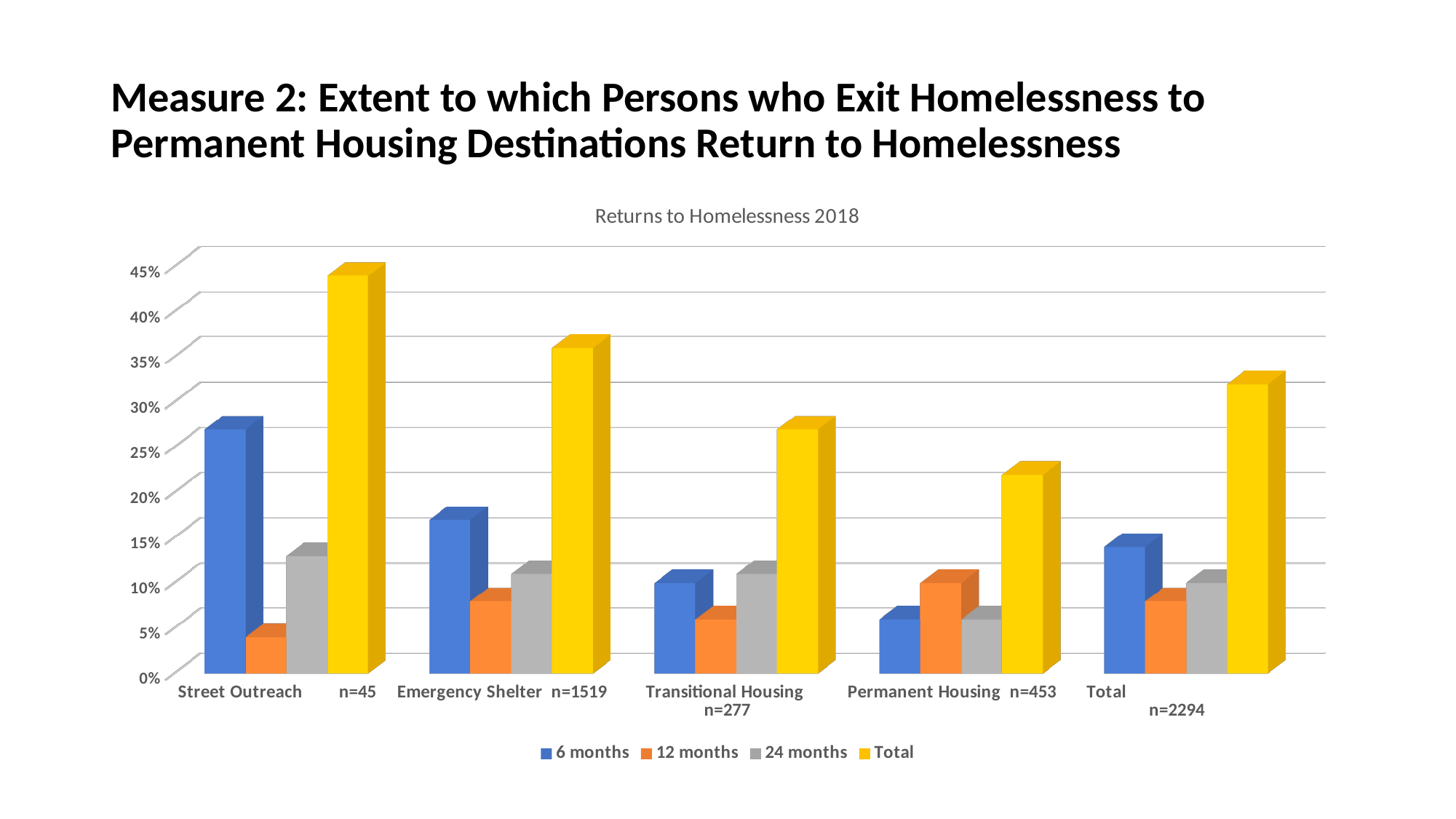
Which category has the highest Total bar? Street Outreach Which is larger, the 6 months value for Street Outreach or the 6 months value for Emergency Shelter? Street Outreach Is the Total value for Permanent Housing greater or less than 25%? less Is the 12 months value for Street Outreach greater or less than 10%? less Is the 6 months value for Street Outreach greater or less than 20%? greater What sample size (n) is shown for Emergency Shelter? n=1519 What kind of chart is shown on the slide? bar chart How many categories are shown along the x axis? 5 What is the title of the chart? Returns to Homelessness 2018 Which category has the lowest Total bar? Permanent Housing How many series does the legend list? 4